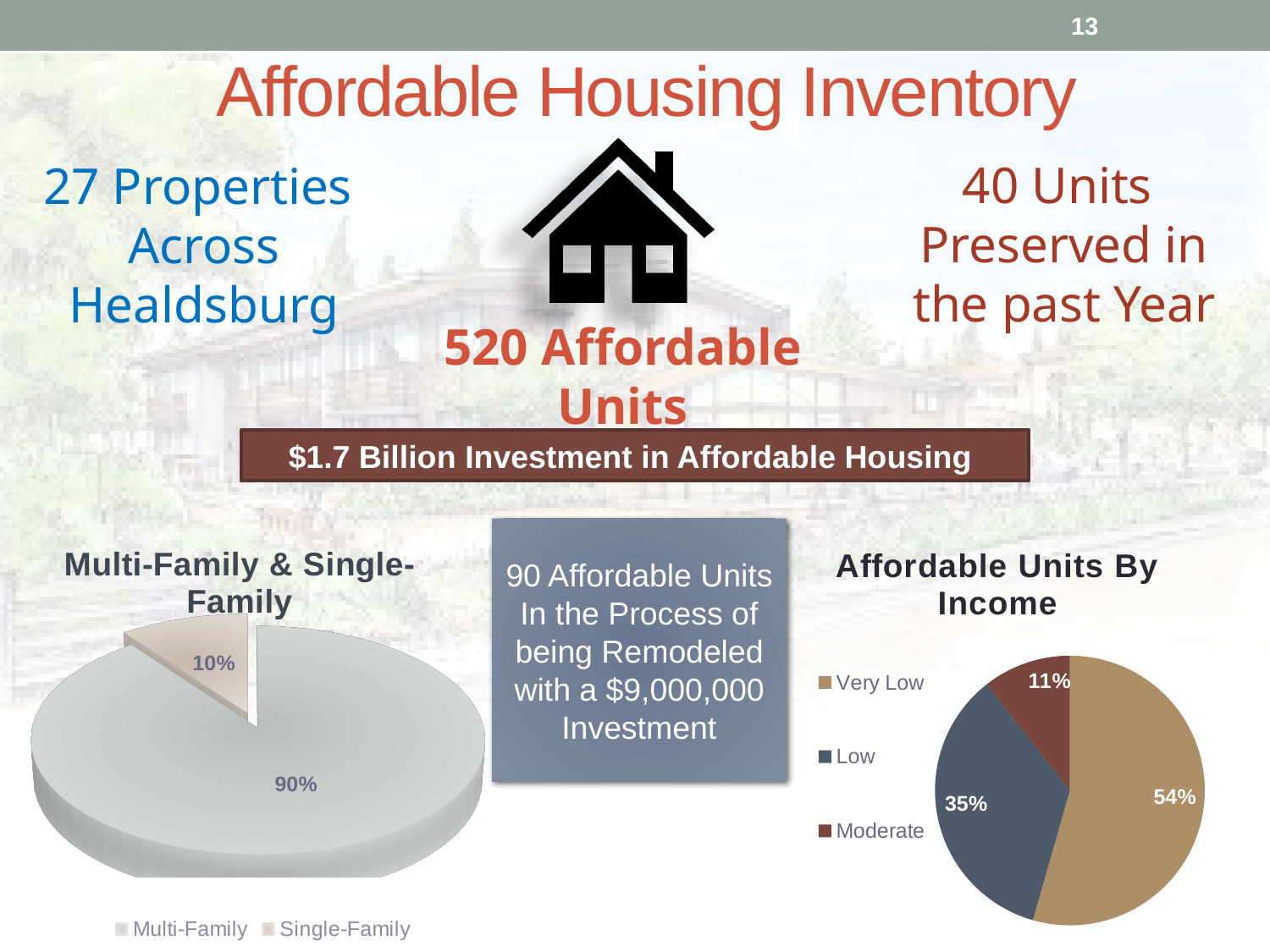
In the 'Multi-Family & Single-Family' chart, what is the difference between the Multi-Family and Single-Family shares? 80% In the 'Affordable Units By Income' chart, what share is Very Low? 54% In the 'Affordable Units By Income' chart, what share is Moderate? 11% What kind of chart is the 'Multi-Family & Single-Family' chart? Pie chart How many series does the legend of the 'Multi-Family & Single-Family' chart list? 2 In the 'Multi-Family & Single-Family' chart, what share is Multi-Family? 90% In the 'Affordable Units By Income' chart, which income category has the largest share? Very Low In the 'Affordable Units By Income' chart, what is the difference between the Very Low and Low shares? 19% How many categories does the legend of the 'Affordable Units By Income' chart list? 3 In the 'Multi-Family & Single-Family' chart, what share is Single-Family? 10% In the 'Affordable Units By Income' chart, which income category has the smallest share? Moderate In the 'Affordable Units By Income' chart, what share is Low? 35%